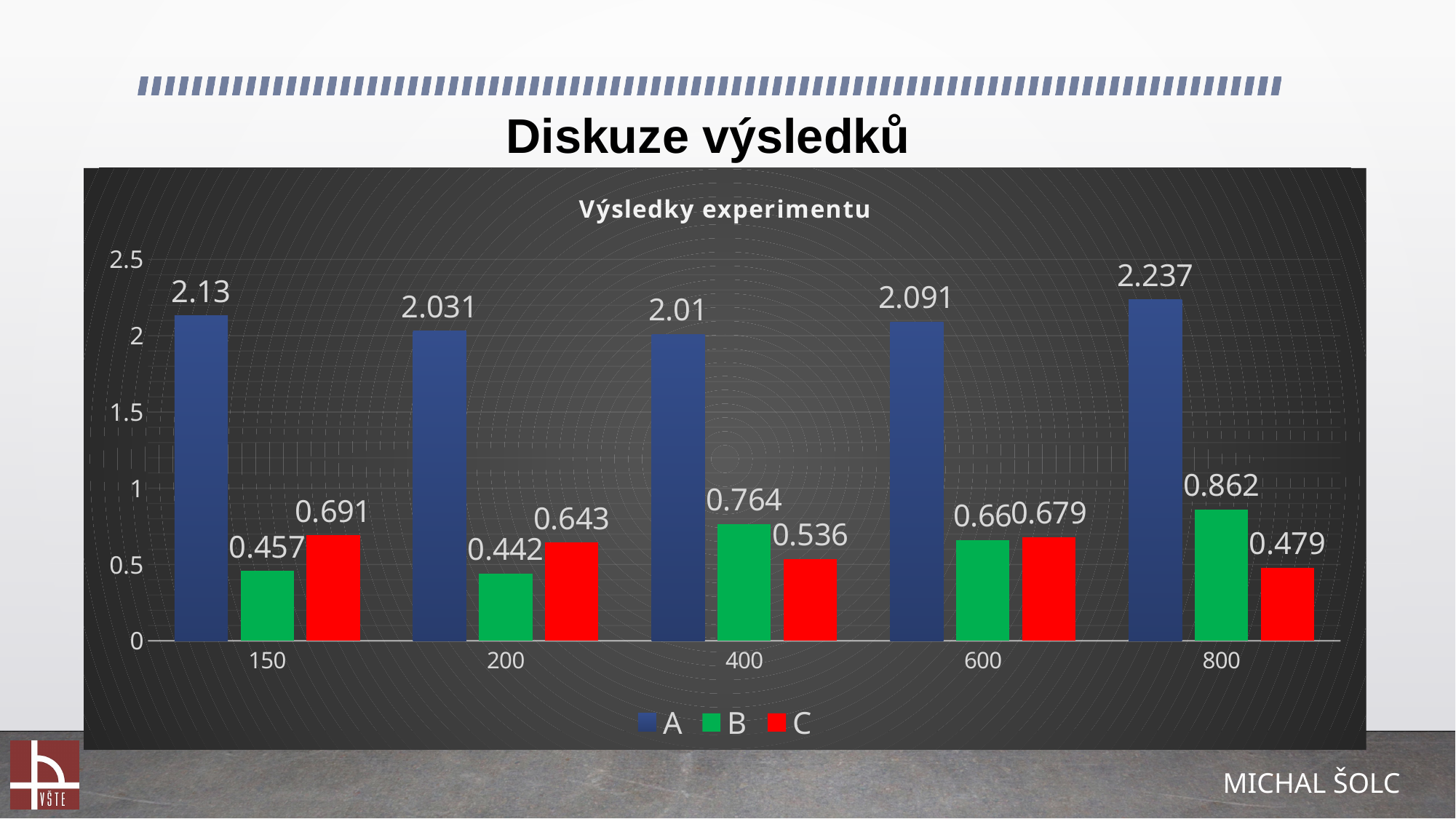
What is the value of series A at category 150? 2.13 How many series does the legend list? 3 At which category does series A reach its highest value? 800 What is the difference between the value of series A at 800 and at 400? 0.227 What is the value of series B at category 400? 0.764 What kind of chart is shown on the slide? bar chart Is the value for series C at category 400 greater or less than 1? less What is the title of the chart? Výsledky experimentu At category 800, which is larger, series B or series C? B How many categories are shown on the x axis? 5 At which category does series B have its lowest value? 200 What is the value of series C at category 800? 0.479